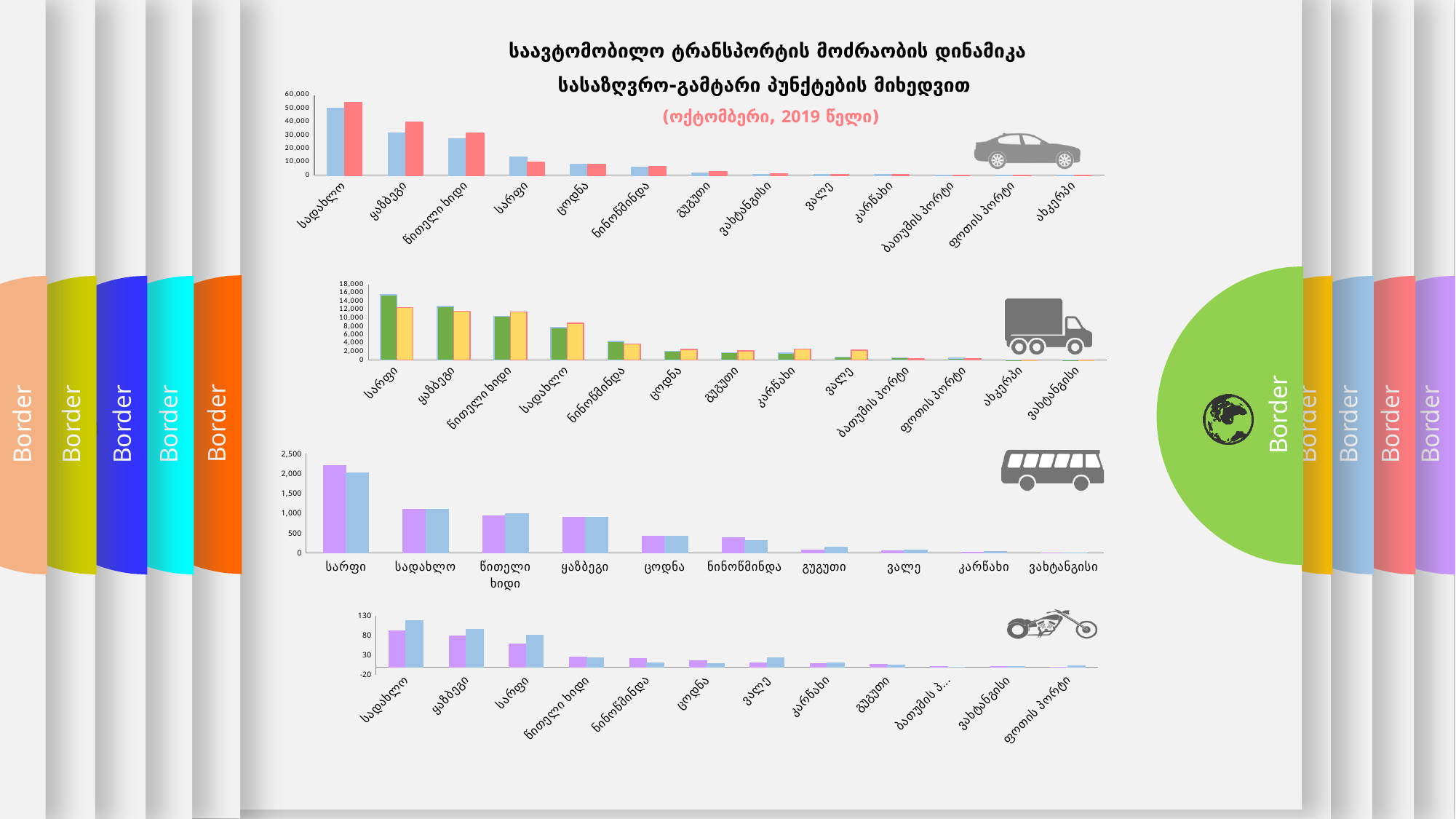
In the third chart (with the bus icon), is the value of the first (purple) bar for სარფი greater or less than 2,000? greater How many categories are shown on the x axis of the top chart (with the car icon)? 13 In the third chart (with the bus icon), do the values generally rise or fall from left to right along the x axis? fall What kind of chart is the top chart (with the car icon) on the slide? bar chart How many categories are shown on the x axis of the third chart (with the bus icon)? 10 In the second chart (with the truck icon), which category has the highest bar? სარფი In the third chart (with the bus icon), which category has the highest bars? სარფი What period is given in the subtitle below the main title of the slide? (ოქტომბერი, 2019 წელი) In the bottom chart (with the motorcycle icon), is the value of the second (blue) bar for სადახლო greater or less than 80? greater In the top chart (with the car icon), which category has the highest bars? სადახლო In the top chart (with the car icon), is the value of the first (blue) bar for სადახლო greater or less than 40,000? greater In the top chart (with the car icon), which category has larger bars: ყაზბეგი or წითელი ხიდი? ყაზბეგი